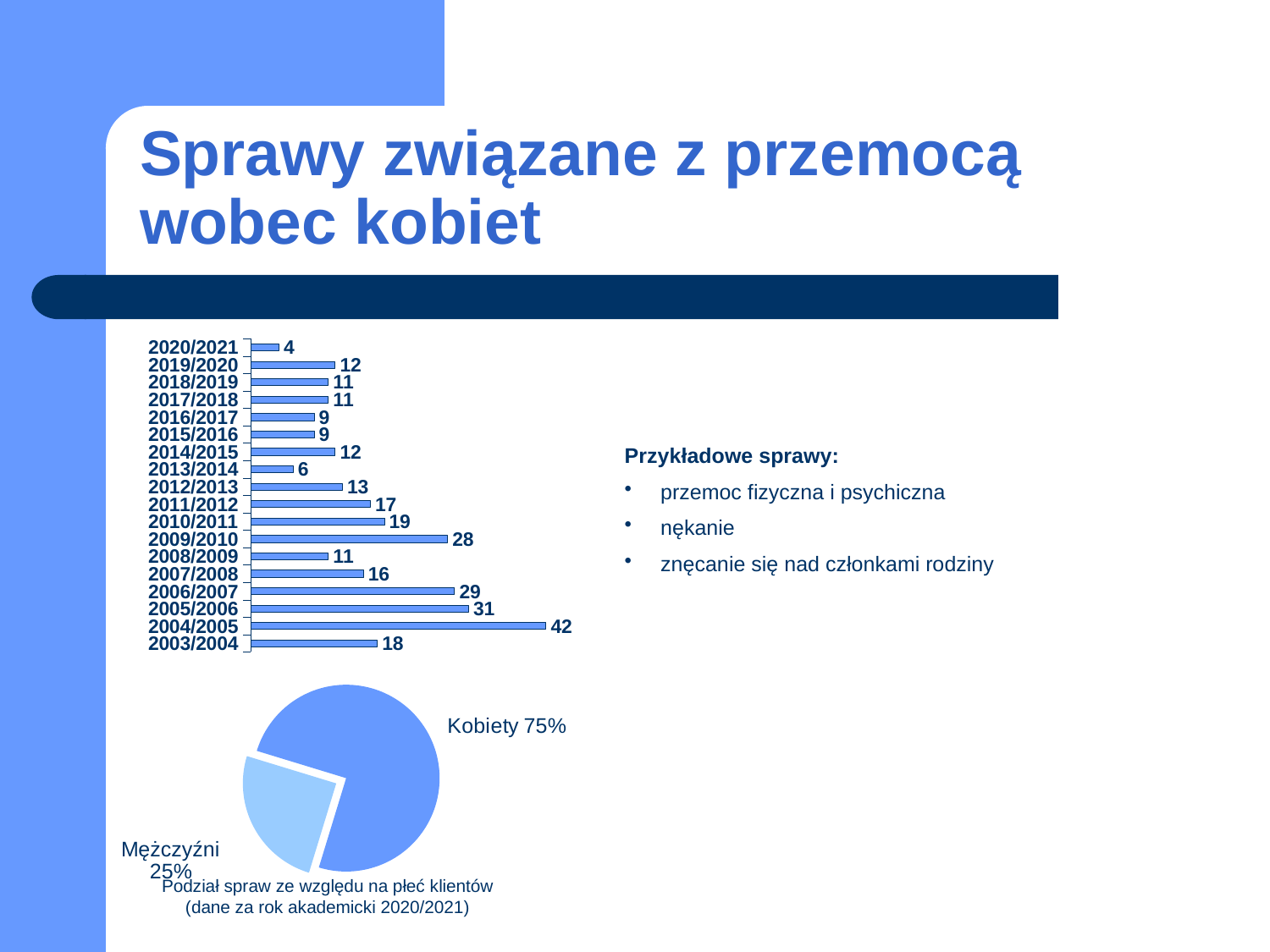
In the bar chart at the top left of the slide, which is larger: the value for 2010/2011 or the value for 2011/2012? 2010/2011 In the pie chart at the bottom left of the slide, what share is labelled Kobiety? 75% In the bar chart at the top left of the slide, what is the value for 2004/2005? 42 In the bar chart at the top left of the slide, which academic year has the lowest value? 2020/2021 In the bar chart at the top left of the slide, what is the value for 2020/2021? 4 How many academic years are shown in the bar chart at the top left of the slide? 18 In the pie chart at the bottom left of the slide, what share is labelled Mężczyźni? 25% What kind of chart is the chart at the top left of the slide? bar chart In the bar chart at the top left of the slide, what is the value for 2009/2010? 28 In the bar chart at the top left of the slide, which academic year has the highest value? 2004/2005 In the bar chart at the top left of the slide, what is the difference between the values for 2005/2006 and 2006/2007? 2 What is the title of the pie chart at the bottom left of the slide? Podział spraw ze względu na płeć klientów (dane za rok akademicki 2020/2021)